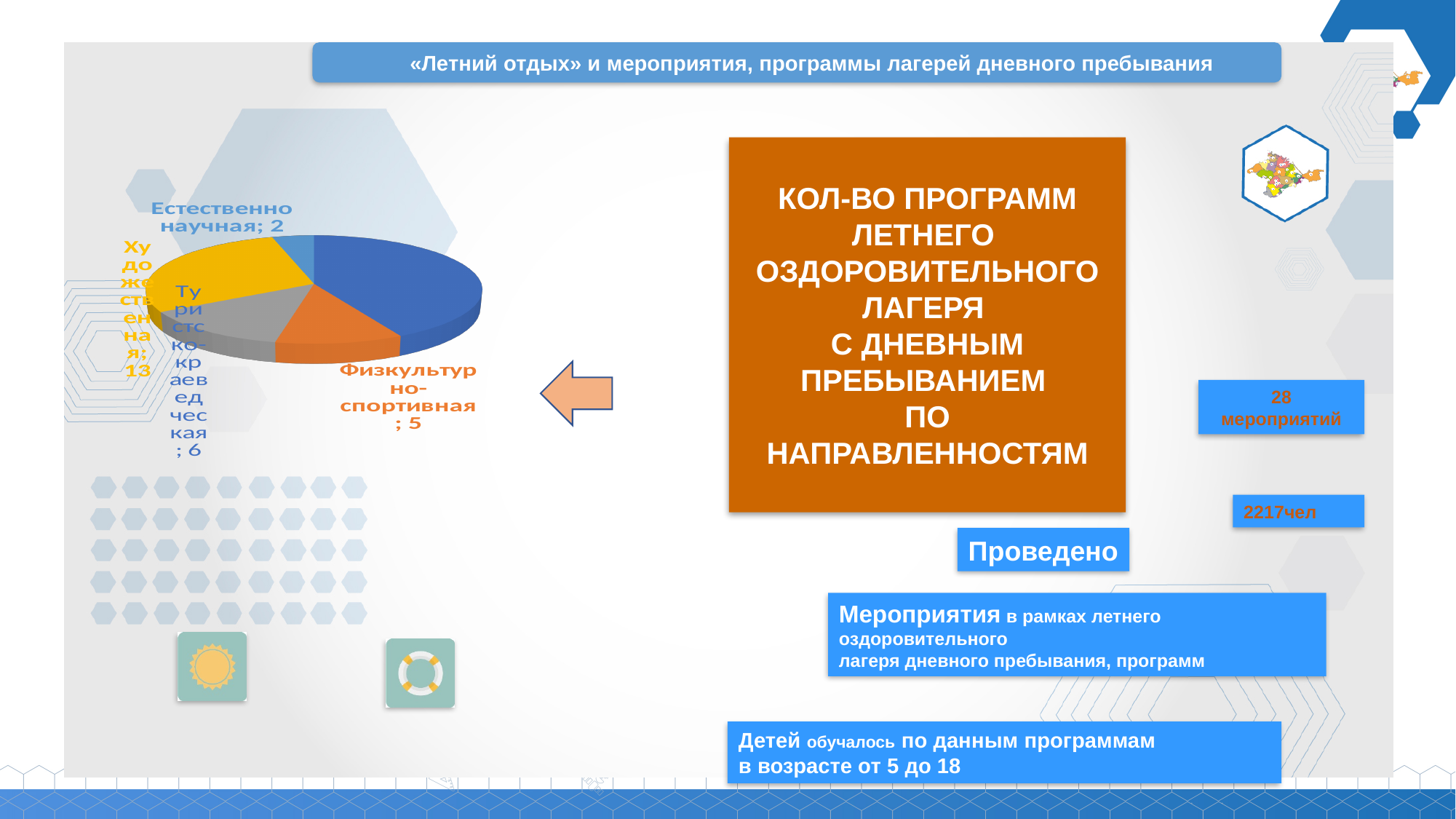
What kind of chart is shown on the slide? pie chart What is the difference between the values for Туристско-краеведческая and Физкультурно-спортивная? 1 Which labelled category in the pie chart has the highest value? Художественная What is the difference between the values for Художественная and Естественно научная? 11 What is the title shown in the orange box next to the pie chart? КОЛ-ВО ПРОГРАММ ЛЕТНЕГО ОЗДОРОВИТЕЛЬНОГО ЛАГЕРЯ С ДНЕВНЫМ ПРЕБЫВАНИЕМ ПО НАПРАВЛЕННОСТЯМ What is the value for Естественно научная in the pie chart? 2 What is the value for Туристско-краеведческая in the pie chart? 6 Which has the larger value, Художественная or Туристско-краеведческая? Художественная What is the value for Физкультурно-спортивная in the pie chart? 5 Which has the larger value, Туристско-краеведческая or Физкультурно-спортивная? Туристско-краеведческая Which labelled category in the pie chart has the lowest value? Естественно научная What is the value for Художественная in the pie chart? 13